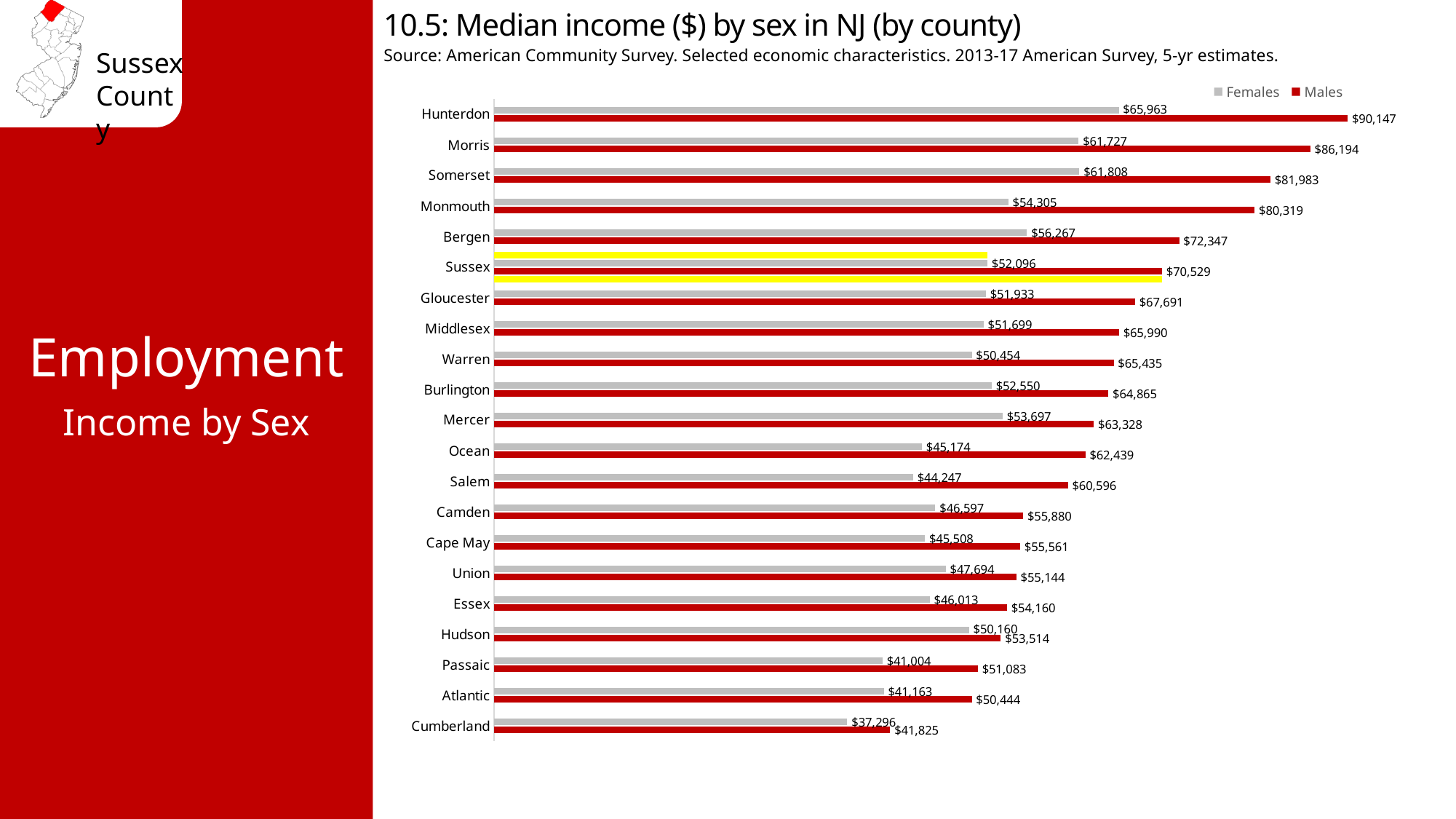
What is the median income for males in Sussex County? $70,529 What type of chart is shown on the slide? Bar chart What is the median income for females in Cumberland County? $37,296 How many counties are shown in the chart? 21 What is the difference between the male and female median incomes in Hunterdon County? $24,184 Which is larger, the female median income in Bergen or in Monmouth? Bergen How many series does the legend list? 2 Which county has the lowest median income for females? Cumberland Which county's bars are highlighted in yellow? Sussex Which county has the highest median income for males? Hunterdon What is the difference between the male and female median incomes in Sussex County? $18,433 What is the median income for females in Hunterdon County? $65,963